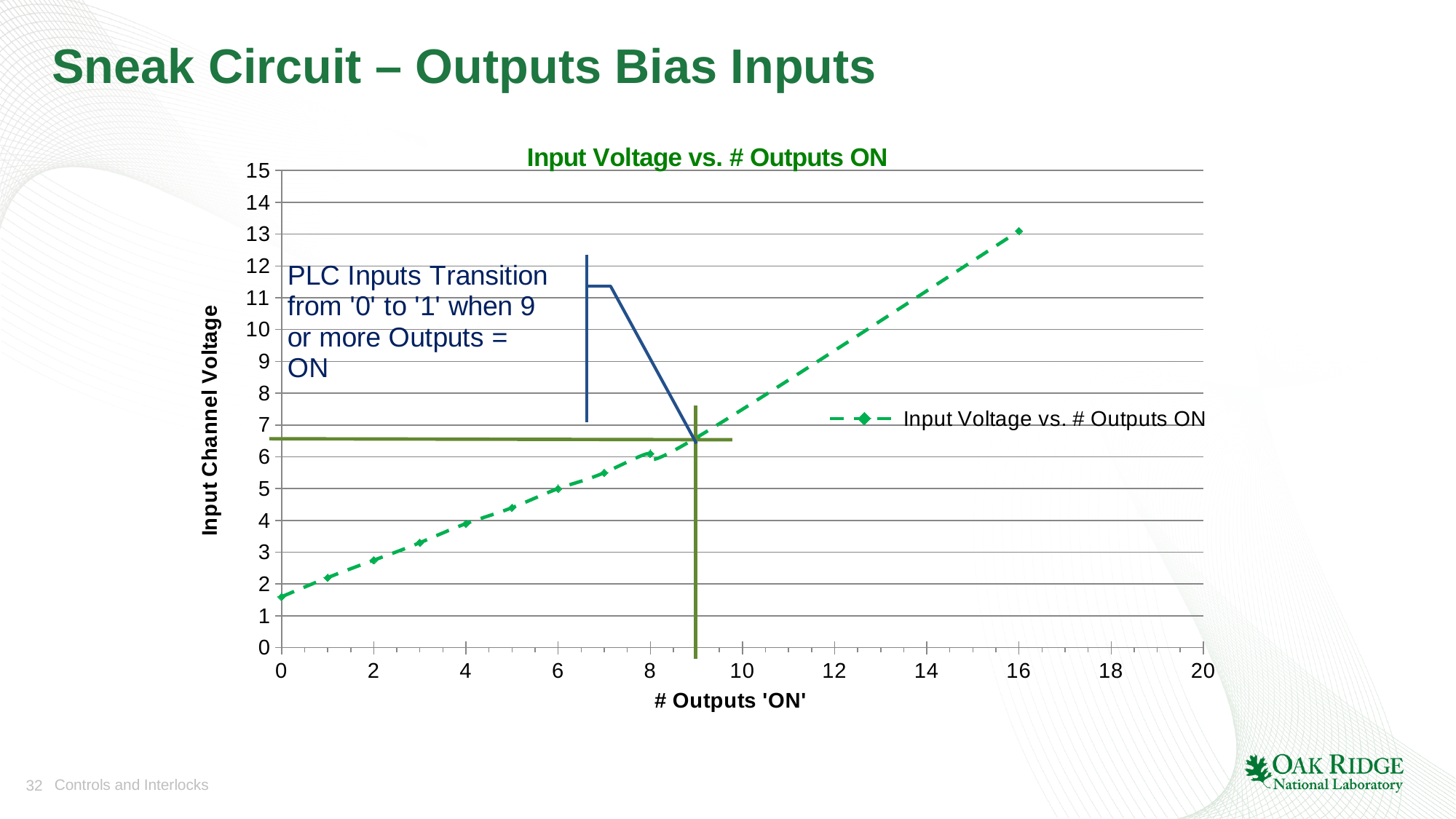
Is the input channel voltage at 0 outputs ON greater or less than 2? less Is the input channel voltage at 16 outputs ON greater or less than 12? greater At which number of outputs ON is the input channel voltage highest? 16 Do the values rise or fall as the number of outputs ON increases along the x axis? rise What kind of chart is shown on the slide? line chart Is the input channel voltage at 4 outputs ON greater or less than 5? less What is the title of the chart? Input Voltage vs. # Outputs ON At which number of outputs ON is the input channel voltage lowest? 0 Which has the larger input channel voltage: 2 outputs ON or 8 outputs ON? 8 outputs ON What is the label of the y axis? Input Channel Voltage How many series does the legend list? 1